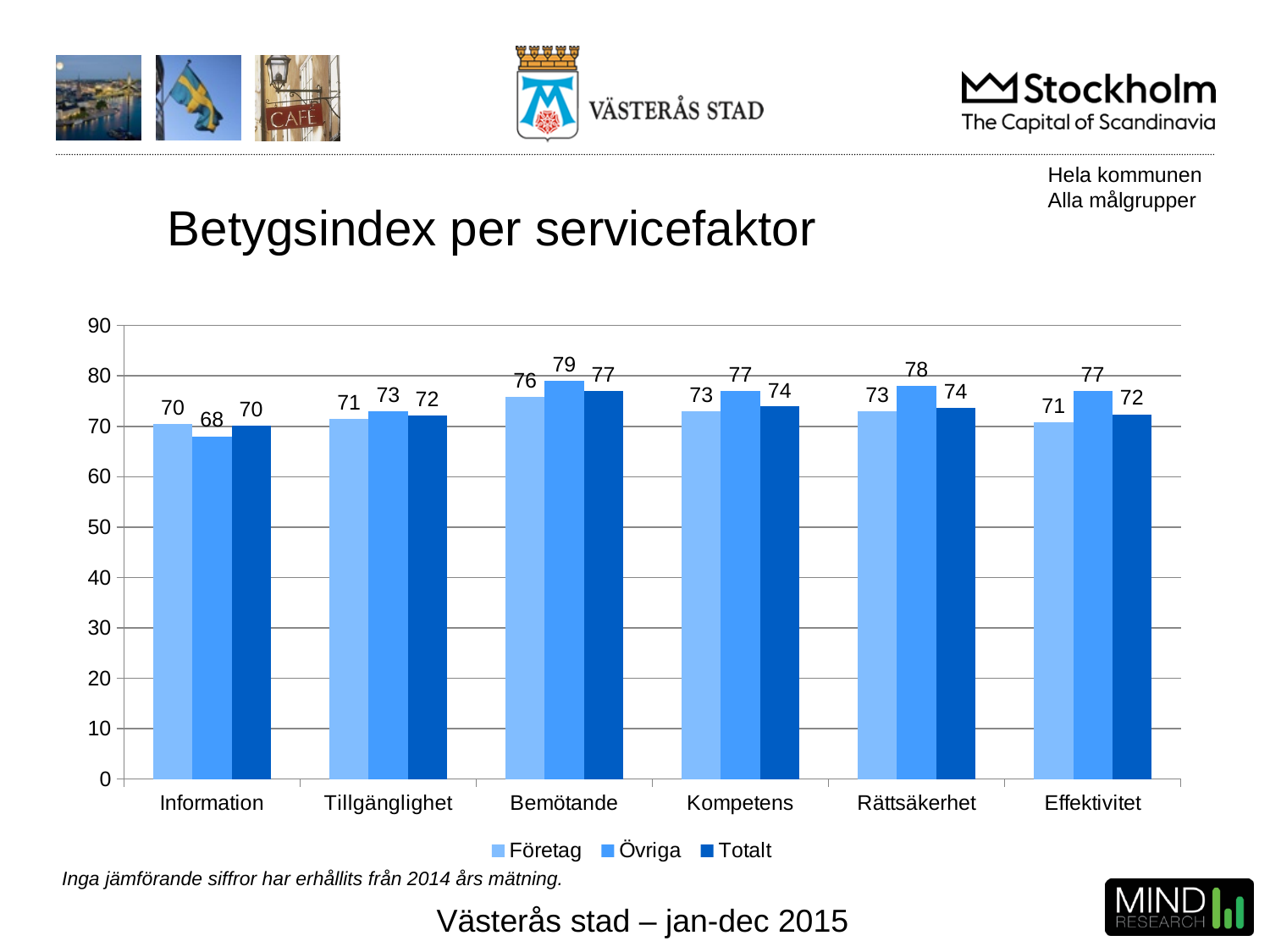
What is the Övriga value for Information? 68 How many categories are shown on the x axis? 6 What kind of chart is shown on the slide? bar chart Which category has the lowest Totalt value? Information How many series does the legend list? 3 Is the Övriga value for Bemötande greater or less than 80? less What is the Företag value for Effektivitet? 71 What is the difference between the Övriga and Företag values for Effektivitet? 6 Which is larger for Rättsäkerhet: the Företag value or the Övriga value? Övriga What is the Totalt value for Bemötande? 77 What is the title of the chart? Betygsindex per servicefaktor Which category has the highest Övriga value? Bemötande